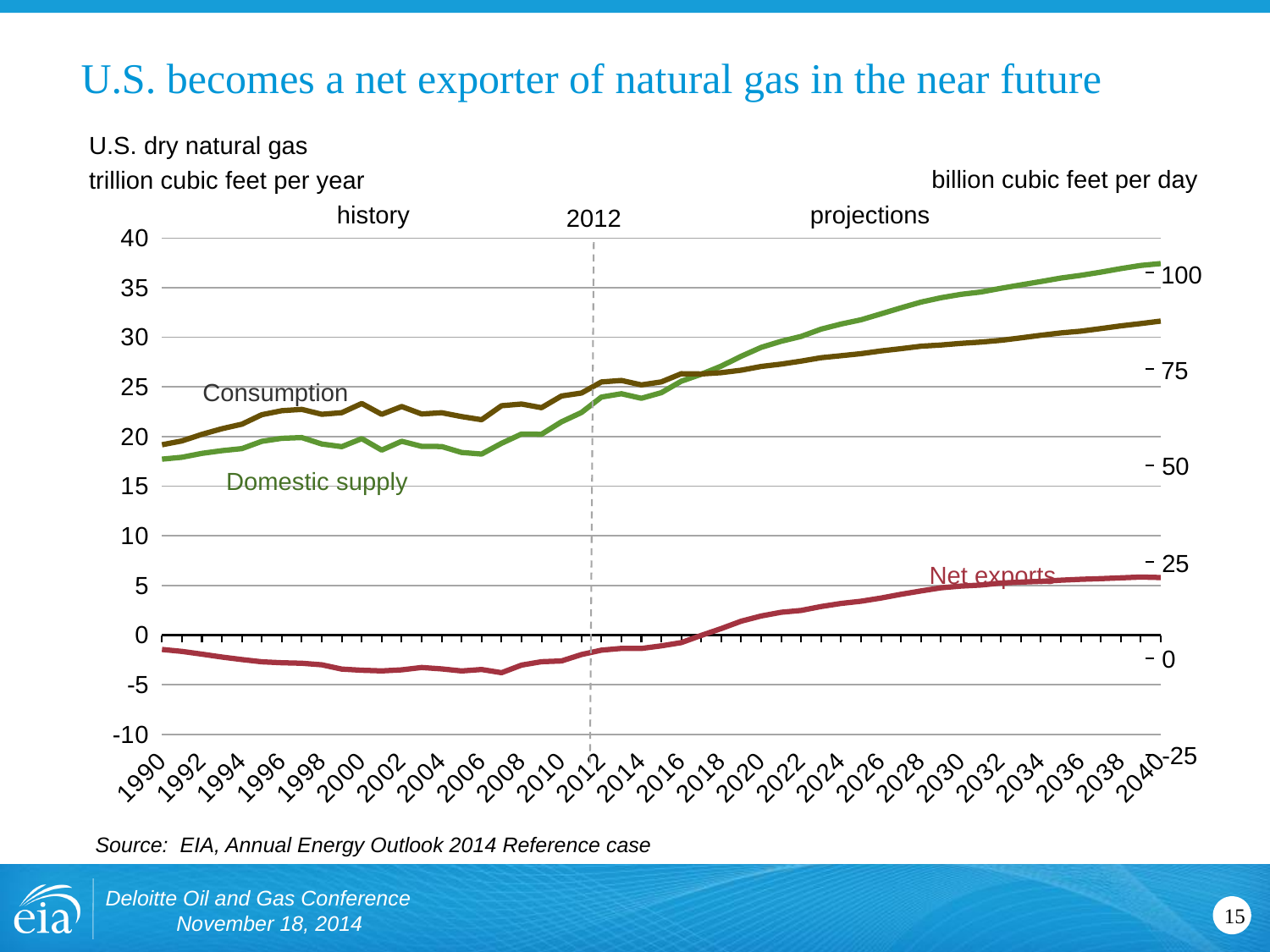
How many data series are plotted on the chart? 3 In 1990, which is larger: Consumption or Domestic supply? Consumption Is the value for Net exports in 1990 greater or less than 0? less Is the value for Domestic supply in 2040 greater or less than 35 trillion cubic feet per year? greater What unit is shown on the right-hand axis of the chart? billion cubic feet per day What kind of chart is shown on the slide? line chart Is the value for Domestic supply in 1990 greater or less than 20 trillion cubic feet per year? less In 2040, which is larger: Consumption or Domestic supply? Domestic supply Does the Net exports line rise or fall between 2012 and 2040? rise Which year does the dashed vertical line separating history from projections mark? 2012 Which series has the highest value in 2040? Domestic supply Which series has the lowest value in 2040? Net exports